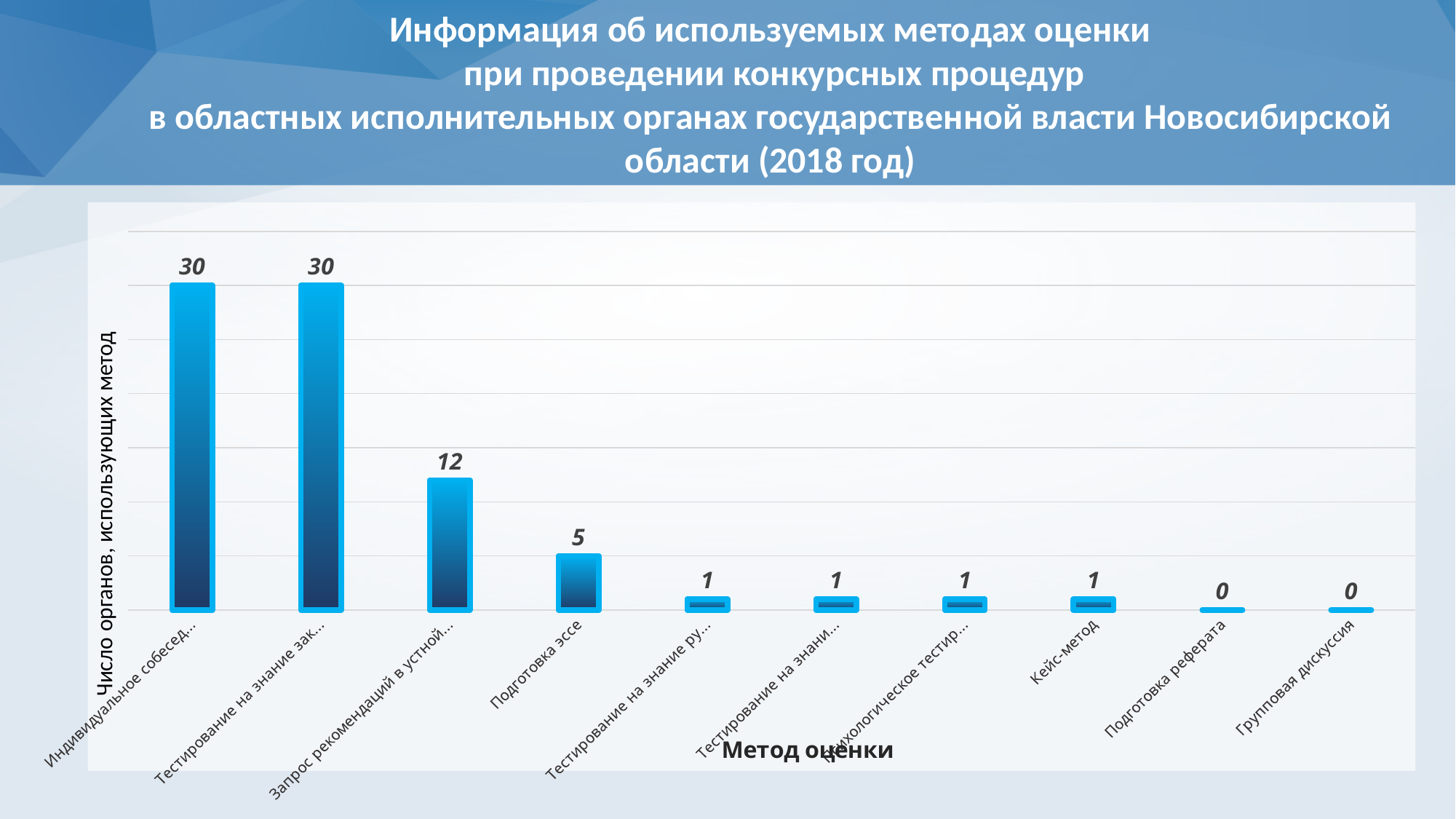
What type of chart is shown on the slide? Bar chart What is the title of the x axis? Метод оценки What is the lowest value shown on the chart? 0 What is the difference between the values for "Подготовка эссе" and "Кейс-метод"? 4 What is the value for "Подготовка эссе"? 5 What is the value for "Групповая дискуссия"? 0 Do the values generally rise or fall from left to right along the x axis? Fall Which has a larger value, "Подготовка эссе" or "Кейс-метод"? Подготовка эссе How many categories (assessment methods) are plotted on the chart? 10 What is the value for "Подготовка реферата"? 0 What is the value for "Кейс-метод"? 1 What is the highest value shown on the chart? 30